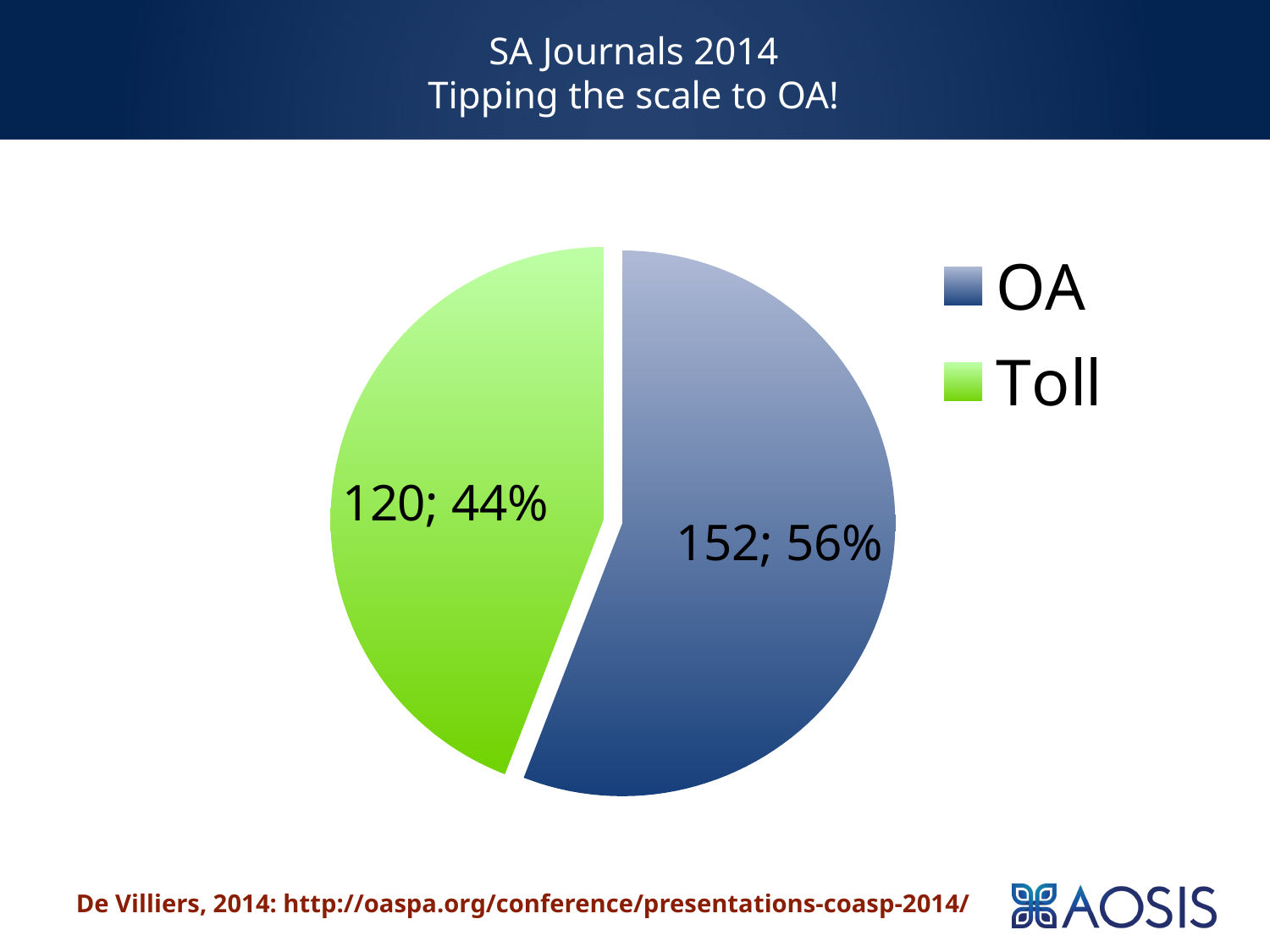
Which category has the smallest slice in the pie chart? Toll How many entries does the legend list? 2 How many journals are OA according to the pie chart? 152 What is the difference between the OA count and the Toll count? 32 What is the total number of journals represented in the pie chart? 272 Which category has the larger slice, OA or Toll? OA How many slices does the pie chart have? 2 What colour is the Toll slice in the pie chart? green How many journals are Toll according to the pie chart? 120 What kind of chart is shown on the slide? pie chart What percentage share of the pie does the Toll slice represent? 44% What percentage share of the pie does the OA slice represent? 56%